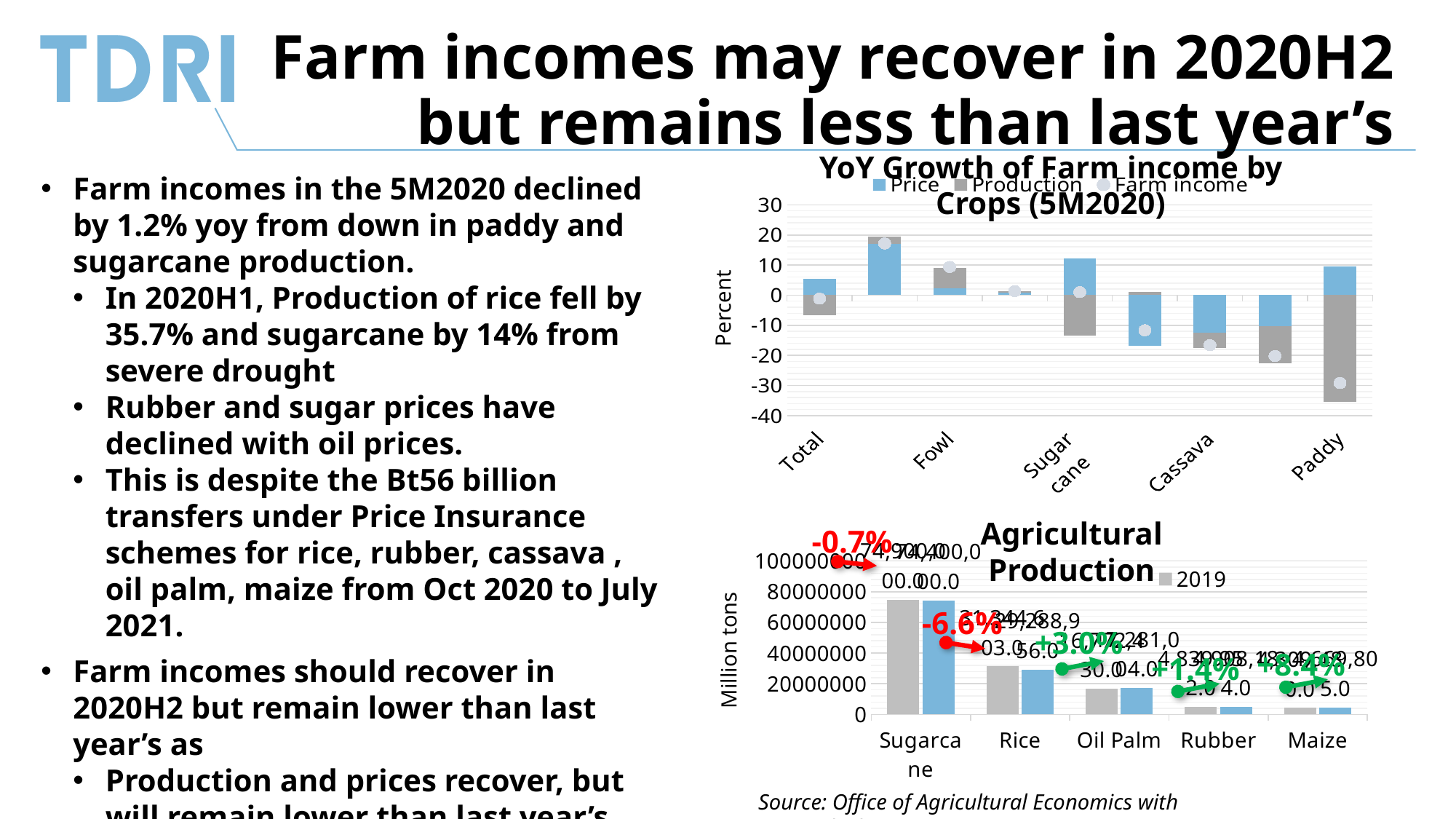
What kind of chart is the 'YoY Growth of Farm income by Crops (5M2020)' chart? combination bar and line chart (stacked bars with Farm income markers) What is the y-axis label of the 'Agricultural Production' chart? Million tons In the 'Agricultural Production' chart, what percentage change is annotated for Rice? -6.6% In the 'YoY Growth of Farm income by Crops (5M2020)' chart, which labelled category has the highest Farm income marker? Fowl In the 'YoY Growth of Farm income by Crops (5M2020)' chart, is the Price value for Fowl greater or less than 10? less In the 'YoY Growth of Farm income by Crops (5M2020)' chart, is the Production value for Paddy greater or less than -30? less In the 'Agricultural Production' chart, what percentage change is annotated for Maize? +8.4% In the 'YoY Growth of Farm income by Crops (5M2020)' chart, is the Farm income value for Cassava greater or less than 0? less How many crop categories are shown on the x axis of the 'Agricultural Production' chart? 5 How many series does the legend of the 'YoY Growth of Farm income by Crops (5M2020)' chart list? 3 In the 'YoY Growth of Farm income by Crops (5M2020)' chart, which labelled crop has the lowest Farm income marker? Paddy In the 'Agricultural Production' chart, which crop has the highest production? Sugarcane